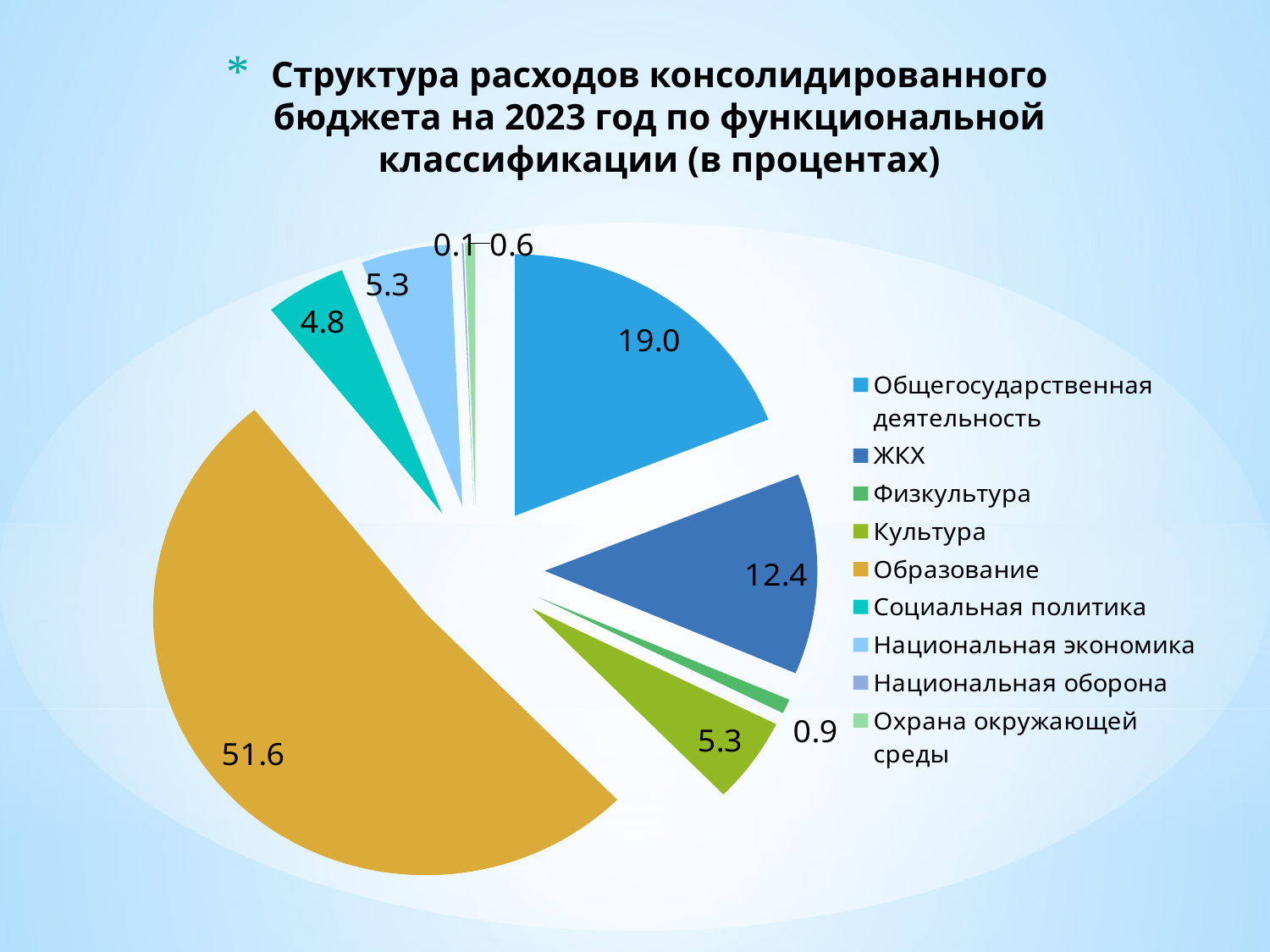
Which category has the smallest share of the pie? Национальная оборона What is the value for Образование? 51.6 What is the value for Физкультура? 0.9 What is the value for Социальная политика? 4.8 What kind of chart is shown on the slide? pie chart What is the difference between the values for Общегосударственная деятельность and ЖКХ? 6.6 Which category has the largest share of the pie? Образование What colour is the slice for Образование? gold How many categories does the legend list? 9 Which is larger, the value for Социальная политика or the value for Национальная экономика? Национальная экономика What is the value for ЖКХ? 12.4 What is the value for Общегосударственная деятельность? 19.0